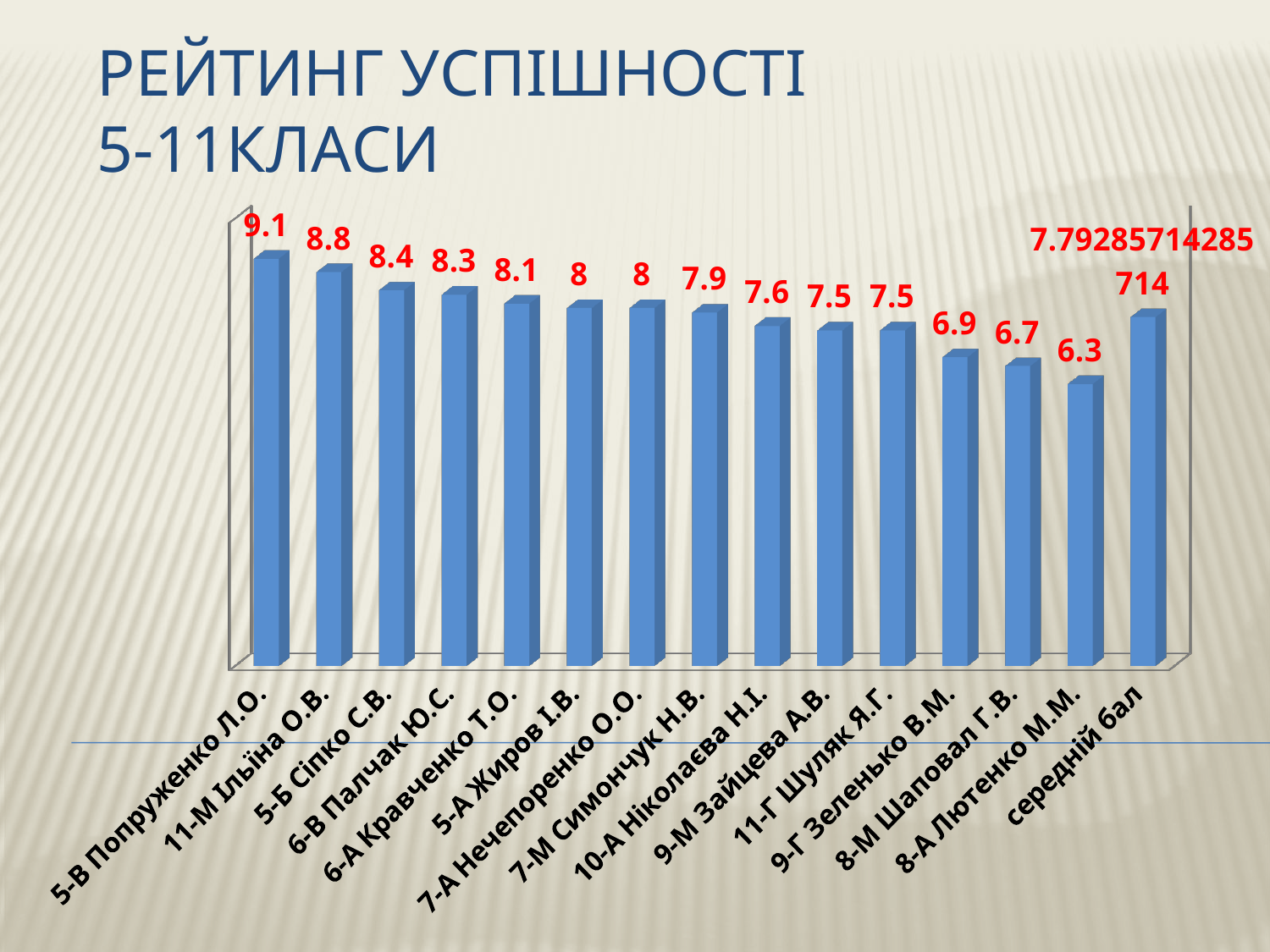
What kind of chart is shown on the slide? bar chart What is the difference between the values for 11-М Ільїна О.В. and 5-Б Сіпко С.В.? 0.4 What is the value for 10-А Ніколаєва Н.І.? 7.6 What is the title of the slide? РЕЙТИНГ УСПІШНОСТІ 5-11КЛАСИ Which is larger, the value for 6-В Палчак Ю.С. or the value for 7-М Симончук Н.В.? 6-В Палчак Ю.С. What is the value for 5-В Попруженко Л.О.? 9.1 Which category has the lowest value? 8-А Лютенко М.М. What is the value for 9-Г Зеленько В.М.? 6.9 What is the difference between the values for 5-В Попруженко Л.О. and 8-А Лютенко М.М.? 2.8 What is the value for 8-А Лютенко М.М.? 6.3 Which category has the highest value? 5-В Попруженко Л.О. How many bars are shown in the chart? 15